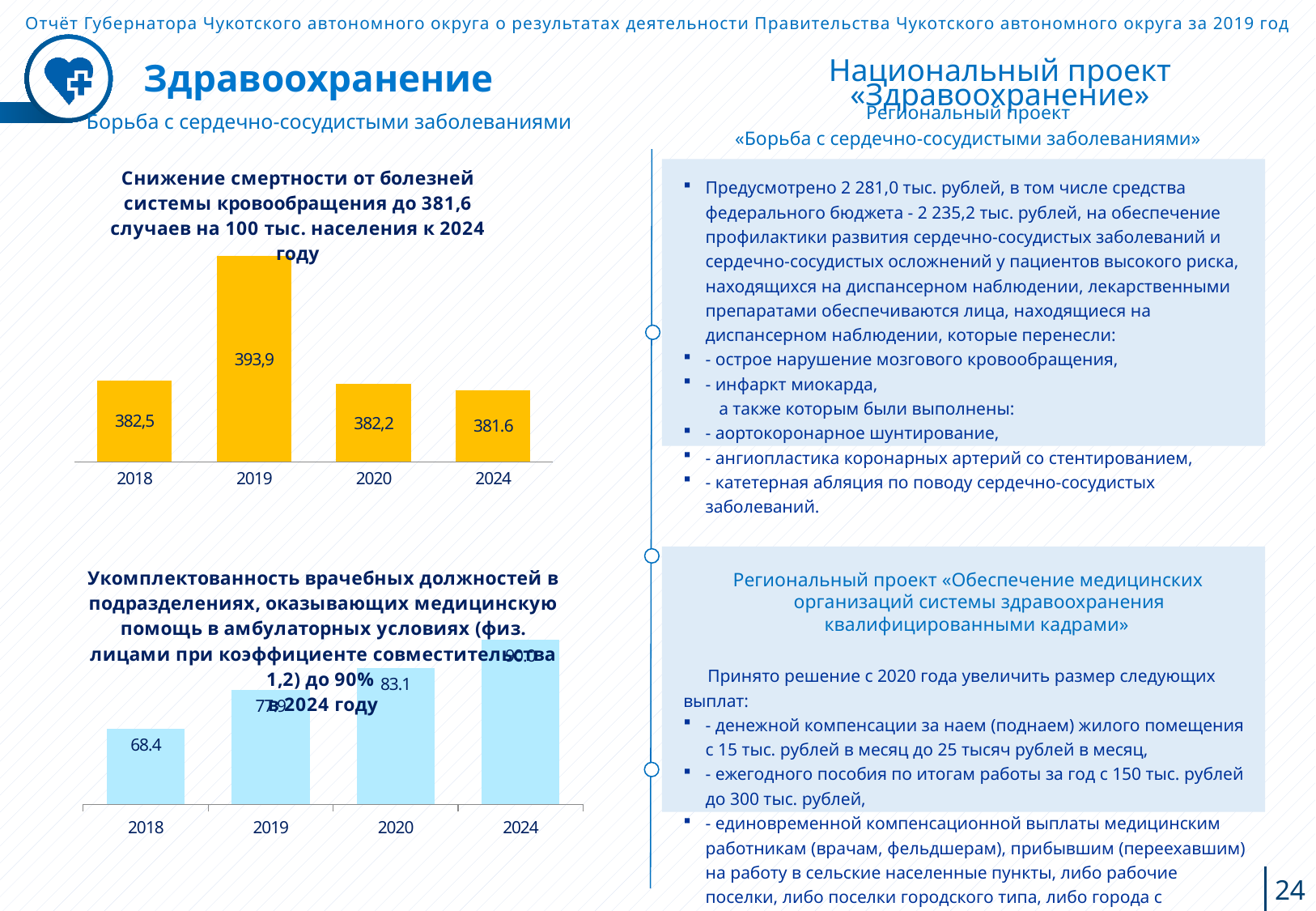
In the top chart (mortality from circulatory system diseases), which year has the highest value? 2019 What colour are the bars in the top chart on the slide? Yellow In the bottom chart (staffing of medical positions), do the values rise or fall from 2018 to 2024? Rise In the top chart (mortality from circulatory system diseases), what is the difference between the 2019 value and the 2020 value? 11,7 In the bottom chart (staffing of medical positions), what is the value for 2018? 68.4 In the top chart (mortality from circulatory system diseases), what is the value for 2018? 382,5 In the bottom chart (staffing of medical positions), which year has the lowest value? 2018 In the bottom chart (staffing of medical positions), what is the value for 2020? 83.1 In the top chart (mortality from circulatory system diseases), what is the value for 2019? 393,9 In the top chart (mortality from circulatory system diseases), what is the value for 2024? 381.6 In the top chart (mortality from circulatory system diseases), how many years are shown on the x axis? 4 What type of chart is the top chart on the slide? Bar chart